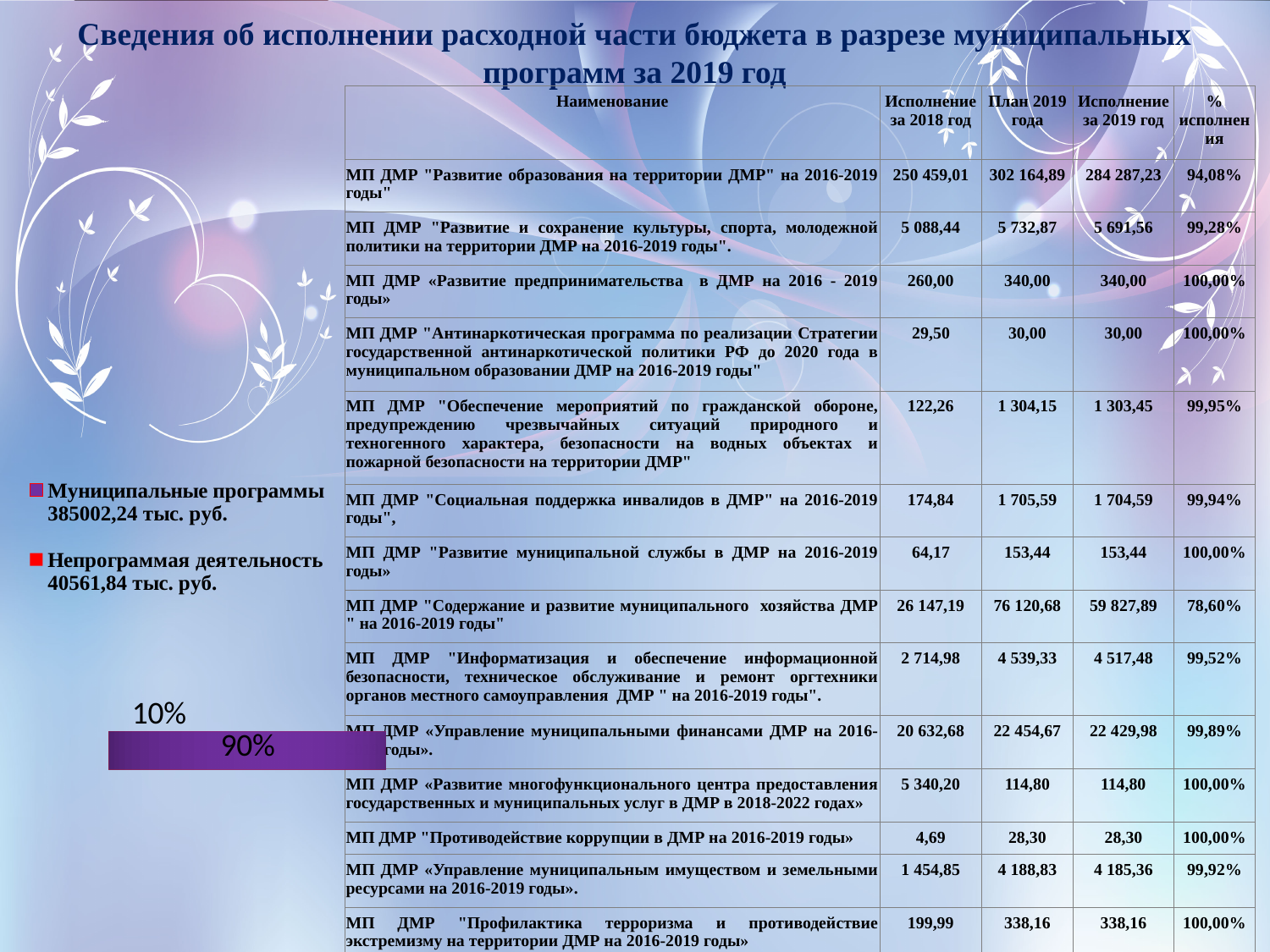
In the chart on the left, which is larger: Муниципальные программы or Непрограммая деятельность? Муниципальные программы What percentage is shown for Непрограммая деятельность in the chart on the left? 10% Which series has the smallest share in the chart on the left? Непрограммая деятельность Which series has the largest share in the chart on the left? Муниципальные программы How many series does the legend of the chart on the left list? 2 What amount does the legend of the chart on the left give for Муниципальные программы? 385002,24 тыс. руб. What percentage is shown for Муниципальные программы in the chart on the left? 90% What colour represents Непрограммая деятельность in the legend of the chart on the left? red What amount does the legend of the chart on the left give for Непрограммая деятельность? 40561,84 тыс. руб. What is the difference in percentage points between the two shares shown in the chart on the left? 80 What is the total of the two percentages shown in the chart on the left? 100% What kind of chart is shown on the left of the slide? pie chart